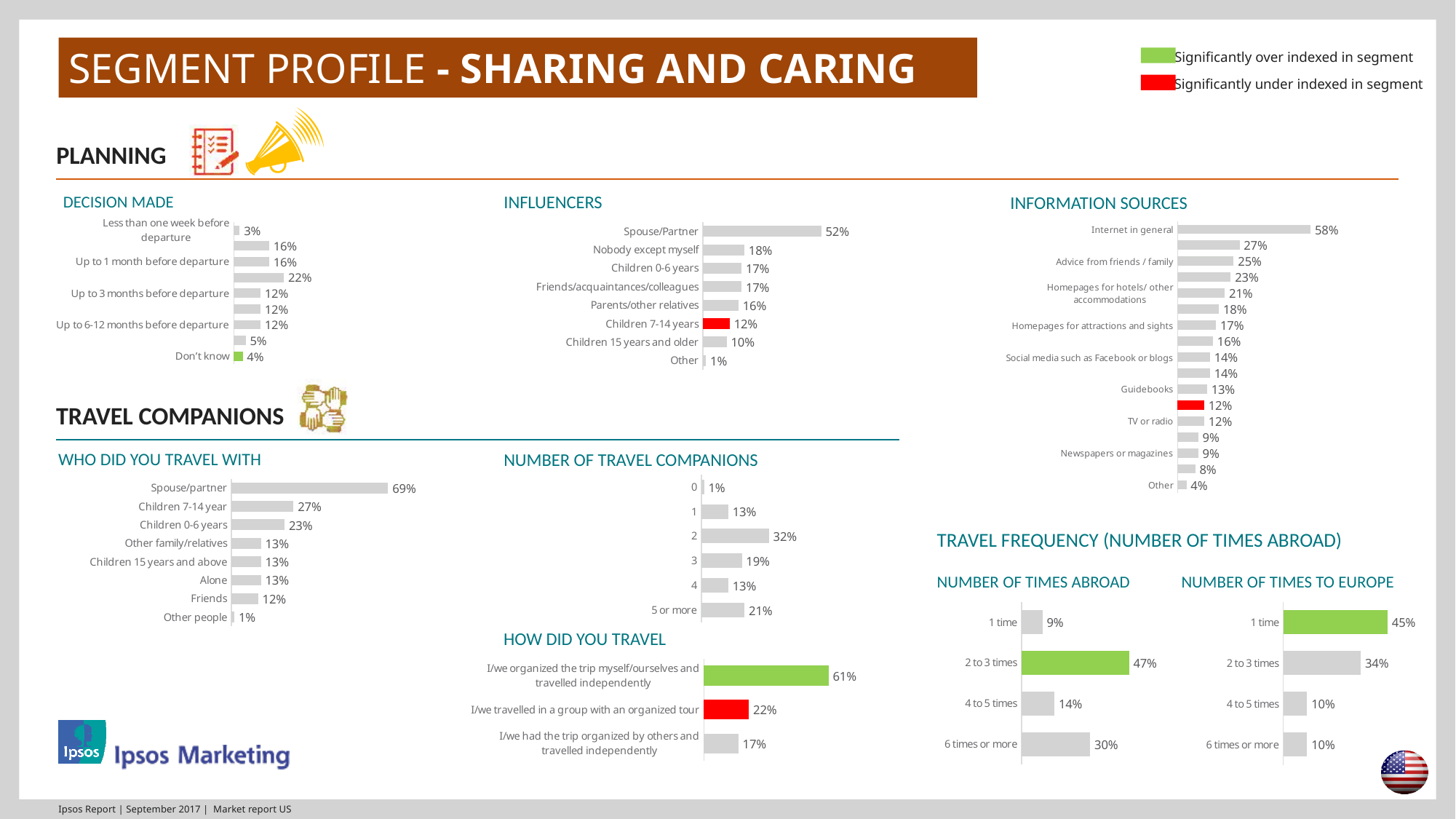
In the WHO DID YOU TRAVEL WITH chart, what is the difference between Spouse/partner and Children 7-14 year? 42% In the DECISION MADE chart, what is the value for Don't know? 4% In the NUMBER OF TIMES ABROAD chart, which is larger: 2 to 3 times or 6 times or more? 2 to 3 times In the NUMBER OF TRAVEL COMPANIONS chart, how many categories are shown? 6 In the NUMBER OF TIMES TO EUROPE chart, what is the value for 1 time? 45% In the INFLUENCERS chart, which category has the lowest value? Other In the INFLUENCERS chart, what is the value for Spouse/Partner? 52% In the NUMBER OF TRAVEL COMPANIONS chart, which category has the highest value? 2 In the WHO DID YOU TRAVEL WITH chart, which category has the highest value? Spouse/partner In the INFORMATION SOURCES chart, what is the value for Internet in general? 58% In the HOW DID YOU TRAVEL chart, what is the value for 'I/we travelled in a group with an organized tour'? 22% What type of chart is the NUMBER OF TIMES ABROAD chart? Bar chart